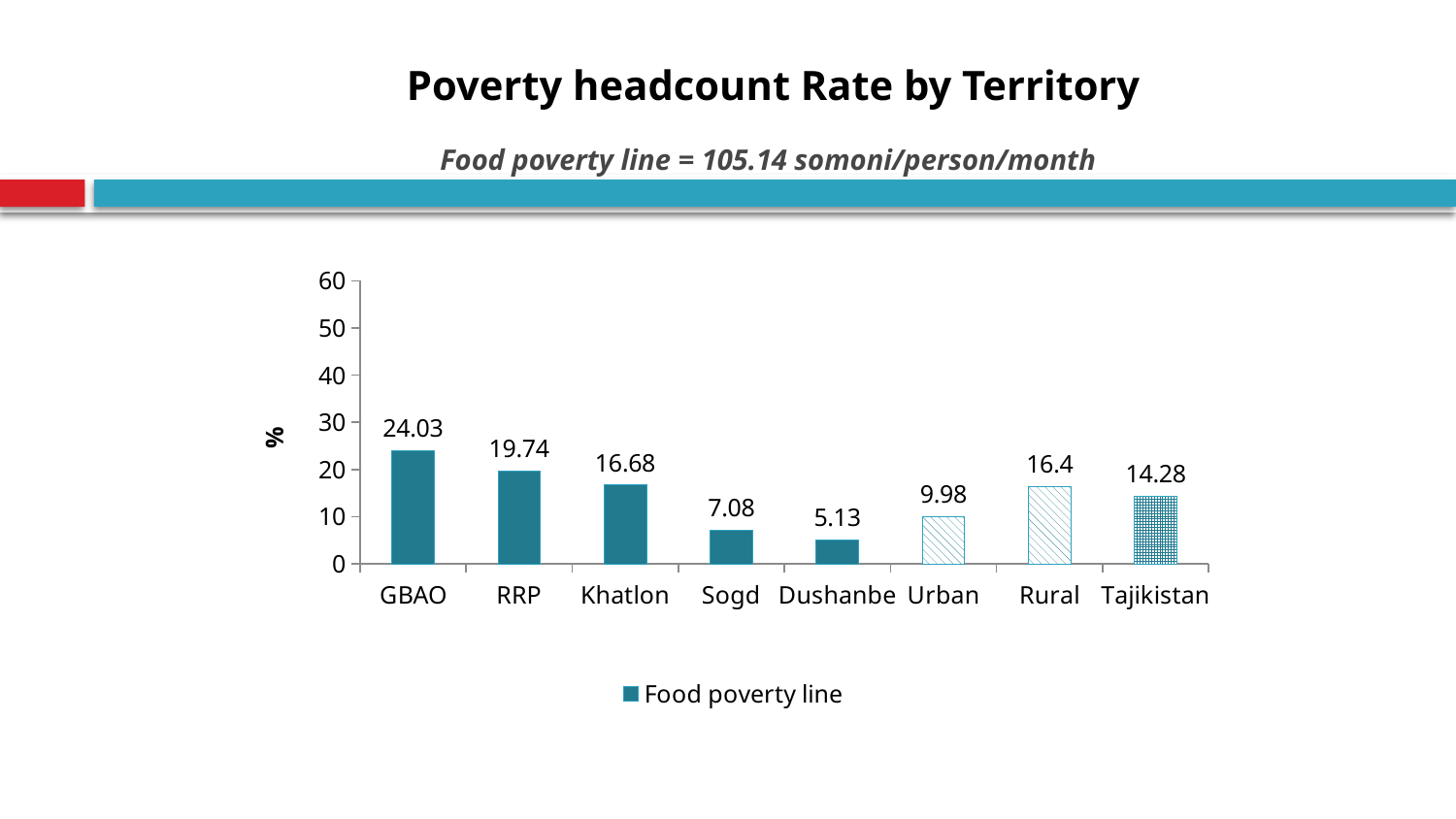
What is the food poverty line stated in the subtitle? 105.14 somoni/person/month Which territory has the highest poverty headcount rate? GBAO What is the poverty headcount rate for Dushanbe? 5.13 What is the difference between the Rural and Urban poverty headcount rates? 6.42 Is the value for Sogd greater or less than 10? less What kind of chart is shown on the slide? Bar chart How many series does the legend list? 1 How many territories are shown on the x axis? 8 Which has a higher poverty headcount rate, RRP or Khatlon? RRP What is the poverty headcount rate for Tajikistan overall? 14.28 Which territory has the lowest poverty headcount rate? Dushanbe What is the poverty headcount rate for GBAO? 24.03